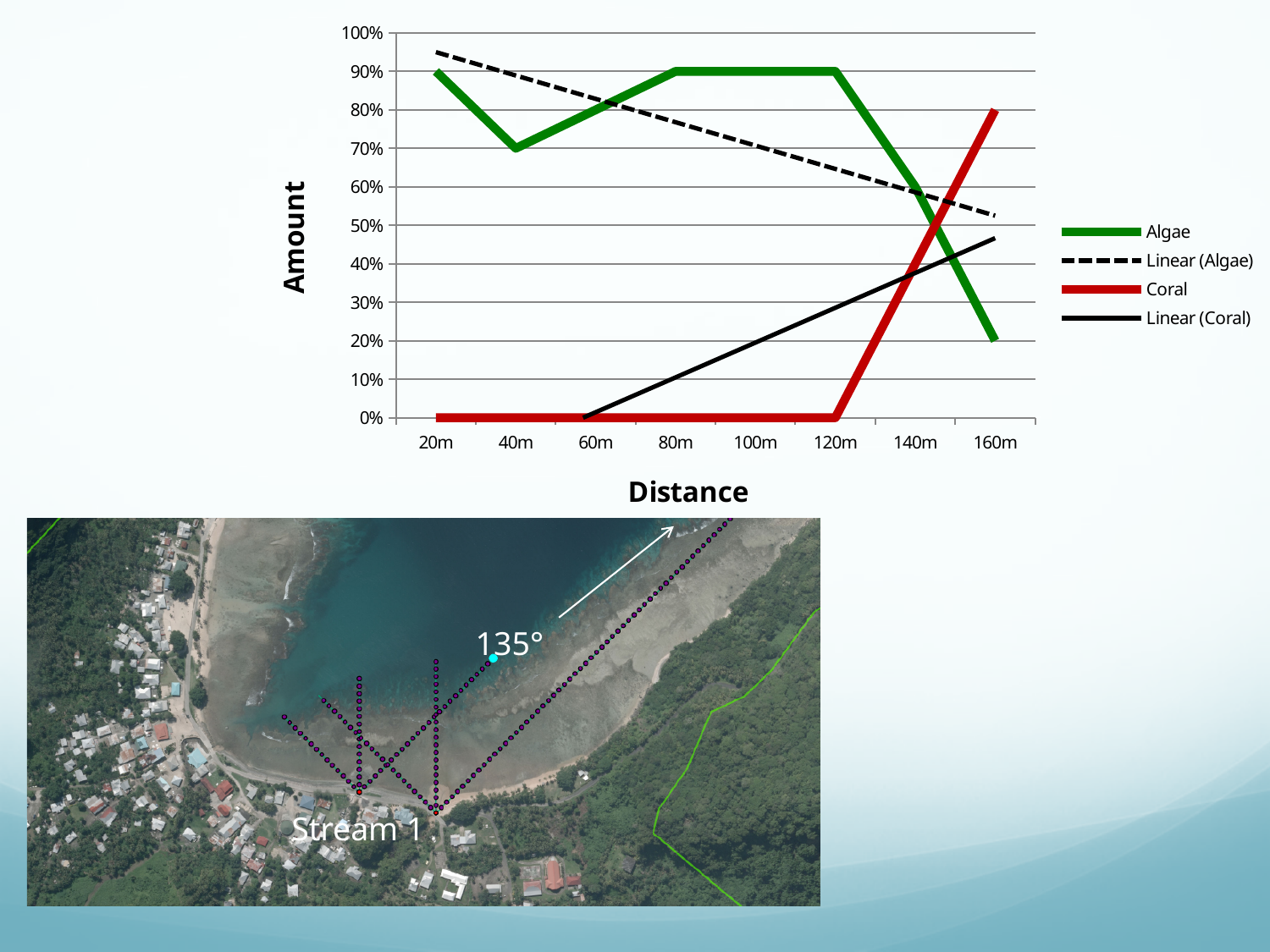
What is the Coral value at 20m? 0% What kind of chart is shown on the slide? line chart At which distance is the Coral value highest? 160m What is the Coral value at 160m? 80% What is the difference between the Algae value at 20m and at 40m? 20% What is the Algae value at 160m? 20% Is the Coral value at 140m greater or less than 20%? greater How many series does the chart's legend list? 4 At which distance is the Algae value lowest? 160m At 40m, which is larger, Algae or Coral? Algae How many distance categories are shown on the x axis? 8 What is the Algae value at 40m? 70%